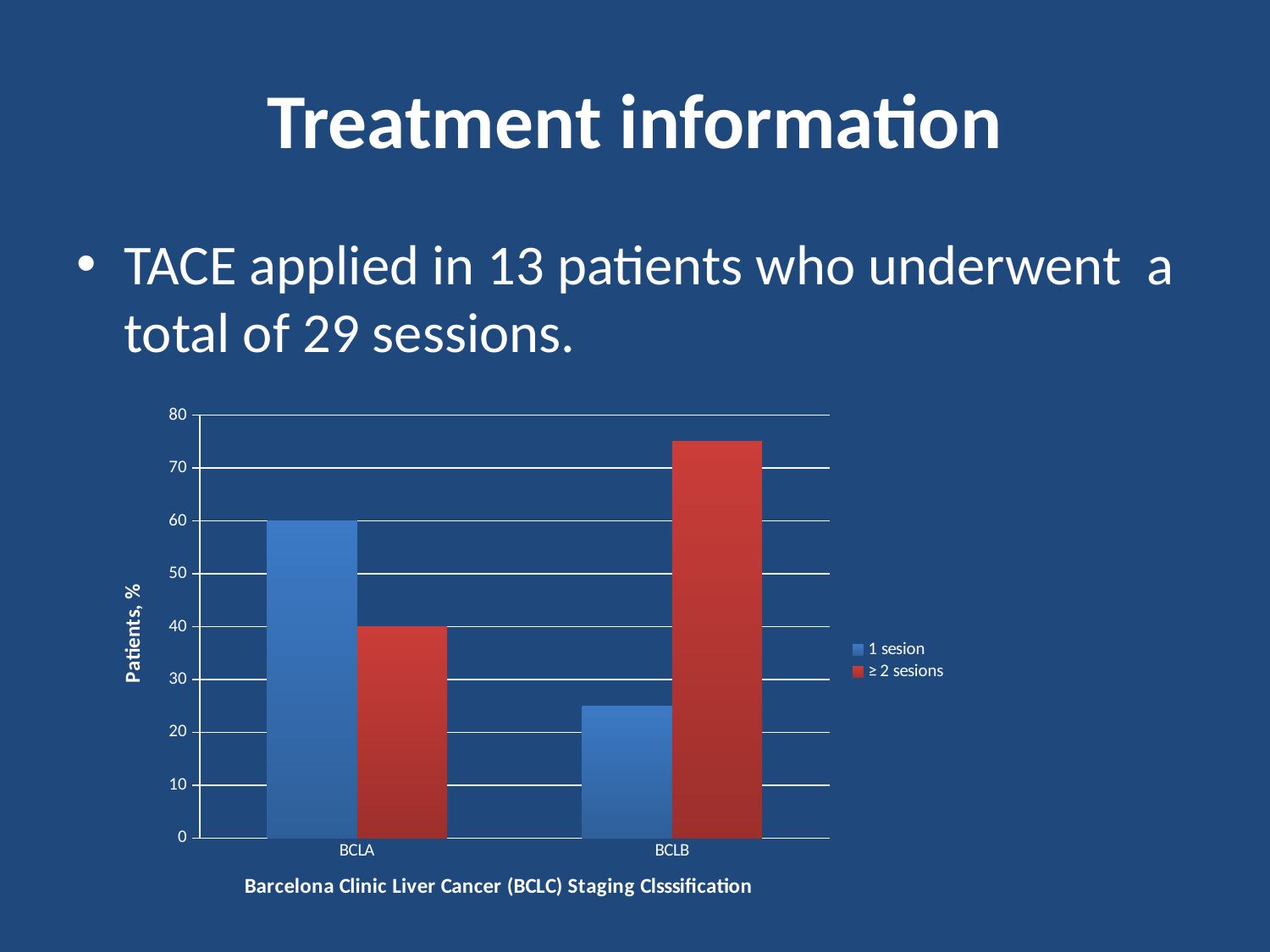
Which bar in the chart is the tallest? ≥ 2 sesions for BCLB How many series does the legend list? 2 Is the value for ≥ 2 sesions in BCLB greater or less than 70? greater What is the value for 1 sesion in the BCLA category? 60 Is the value for 1 sesion in BCLB greater or less than 30? less Which bar in the chart is the shortest? 1 sesion for BCLB Which category has the higher value for ≥ 2 sesions, BCLA or BCLB? BCLB What is the value for ≥ 2 sesions in the BCLA category? 40 What type of chart is shown on the slide? bar chart What is the label of the y axis? Patients, % What is the difference between the 1 sesion and ≥ 2 sesions values for BCLA? 20 Which category has the higher value for 1 sesion, BCLA or BCLB? BCLA